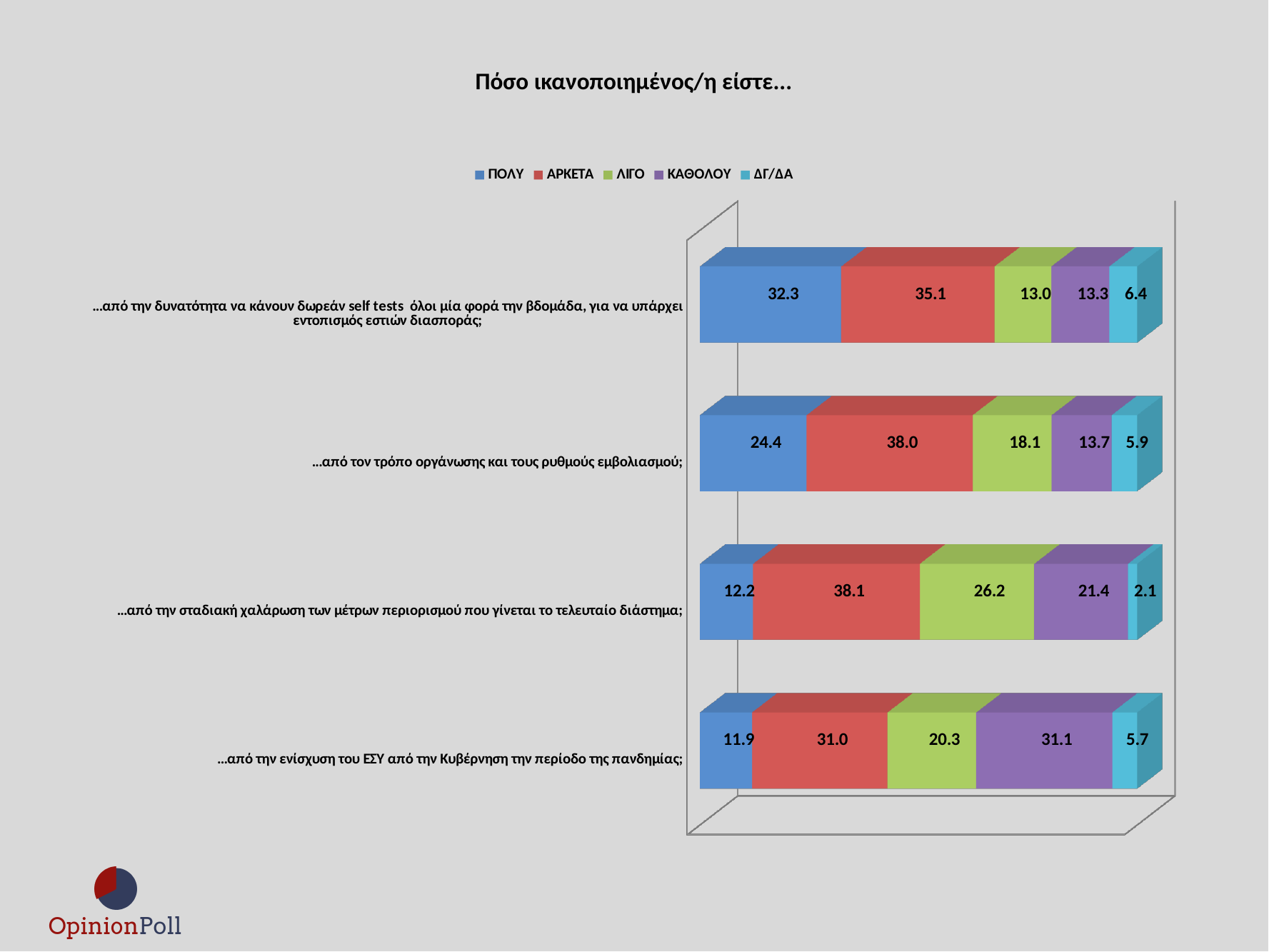
What is the title of the chart? Πόσο ικανοποιημένος/η είστε... What is the ΔΓ/ΔΑ value for "...από την σταδιακή χαλάρωση των μέτρων περιορισμού που γίνεται το τελευταίο διάστημα;"? 2.1 What is the ΠΟΛΥ value for the category about free self tests once a week ("...από την δυνατότητα να κάνουν δωρεάν self tests...")? 32.3 Which is larger: the ΛΙΓΟ value for the relaxation of restriction measures category or the ΛΙΓΟ value for the vaccination organisation category? The relaxation of restriction measures category (26.2) What is the ΚΑΘΟΛΟΥ value for "...από την ενίσχυση του ΕΣΥ από την Κυβέρνηση την περίοδο της πανδημίας;"? 31.1 Which category has the highest ΠΟΛΥ value? ...από την δυνατότητα να κάνουν δωρεάν self tests όλοι μία φορά την βδομάδα, για να υπάρχει εντοπισμός εστιών διασποράς; What is the ΑΡΚΕΤΑ value for "...από τον τρόπο οργάνωσης και τους ρυθμούς εμβολιασμού;"? 38.0 Which category has the lowest ΔΓ/ΔΑ value? ...από την σταδιακή χαλάρωση των μέτρων περιορισμού που γίνεται το τελευταίο διάστημα; How many series does the legend list? 5 How many categories (questions) are plotted on the chart? 4 What is the difference between the ΠΟΛΥ value for the self tests category (32.3) and the ΠΟΛΥ value for the ΕΣΥ category (11.9)? 20.4 What kind of chart is shown on the slide? Stacked bar chart